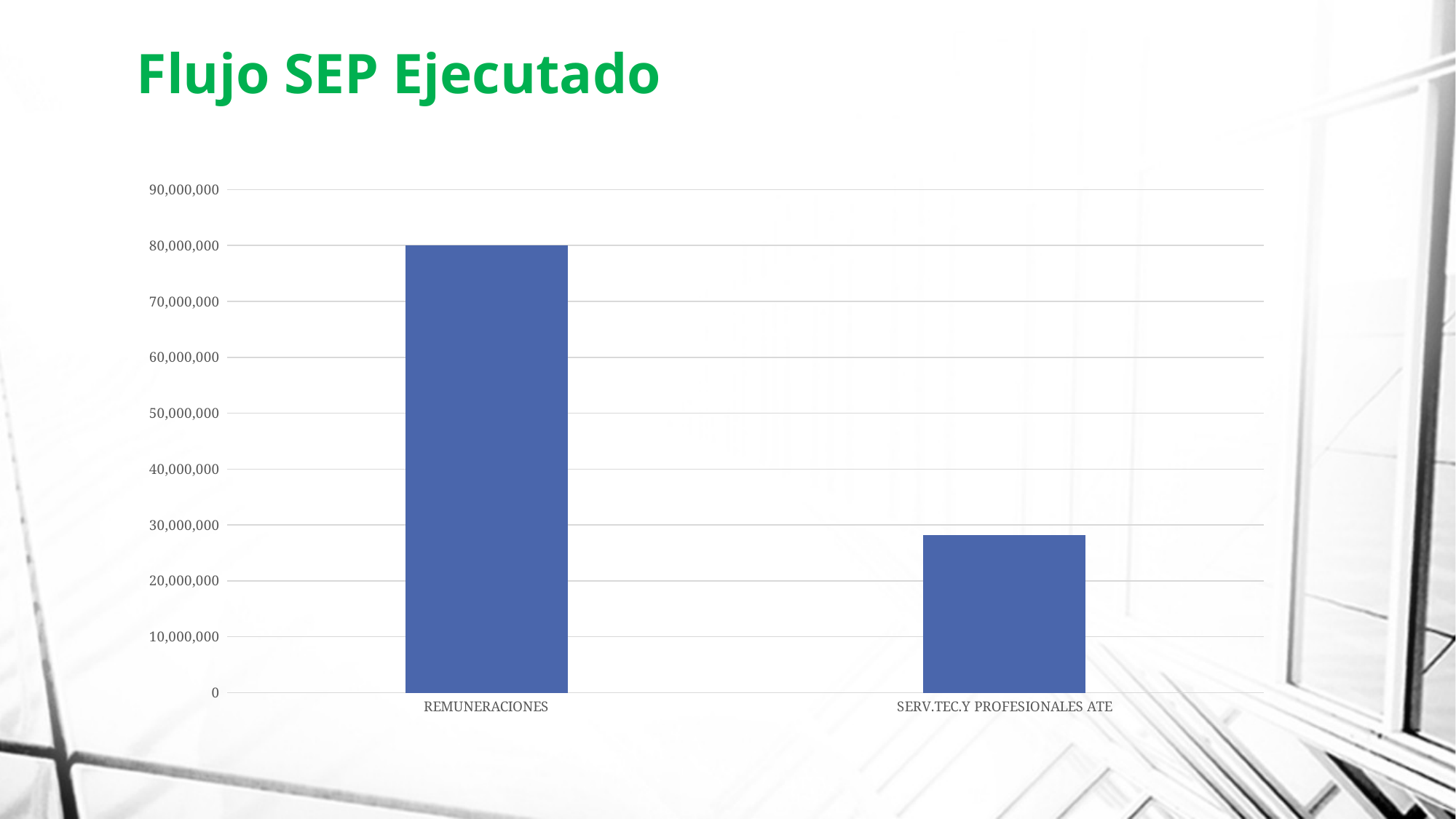
Which category has the highest value? REMUNERACIONES What is the highest value shown on the vertical axis? 90,000,000 What is the value for REMUNERACIONES? 80,000,000 Which category has the lowest value? SERV.TEC.Y PROFESIONALES ATE Is the value for SERV.TEC.Y PROFESIONALES ATE greater or less than 20,000,000? greater What is the title of the slide containing the chart? Flujo SEP Ejecutado Which is larger, the value for REMUNERACIONES or the value for SERV.TEC.Y PROFESIONALES ATE? REMUNERACIONES Is the value for REMUNERACIONES greater or less than 70,000,000? greater How many categories are plotted in the chart? 2 Is the value for SERV.TEC.Y PROFESIONALES ATE greater or less than 30,000,000? less What type of chart is shown on the slide? Bar chart Do the values rise or fall from left to right along the x axis? fall